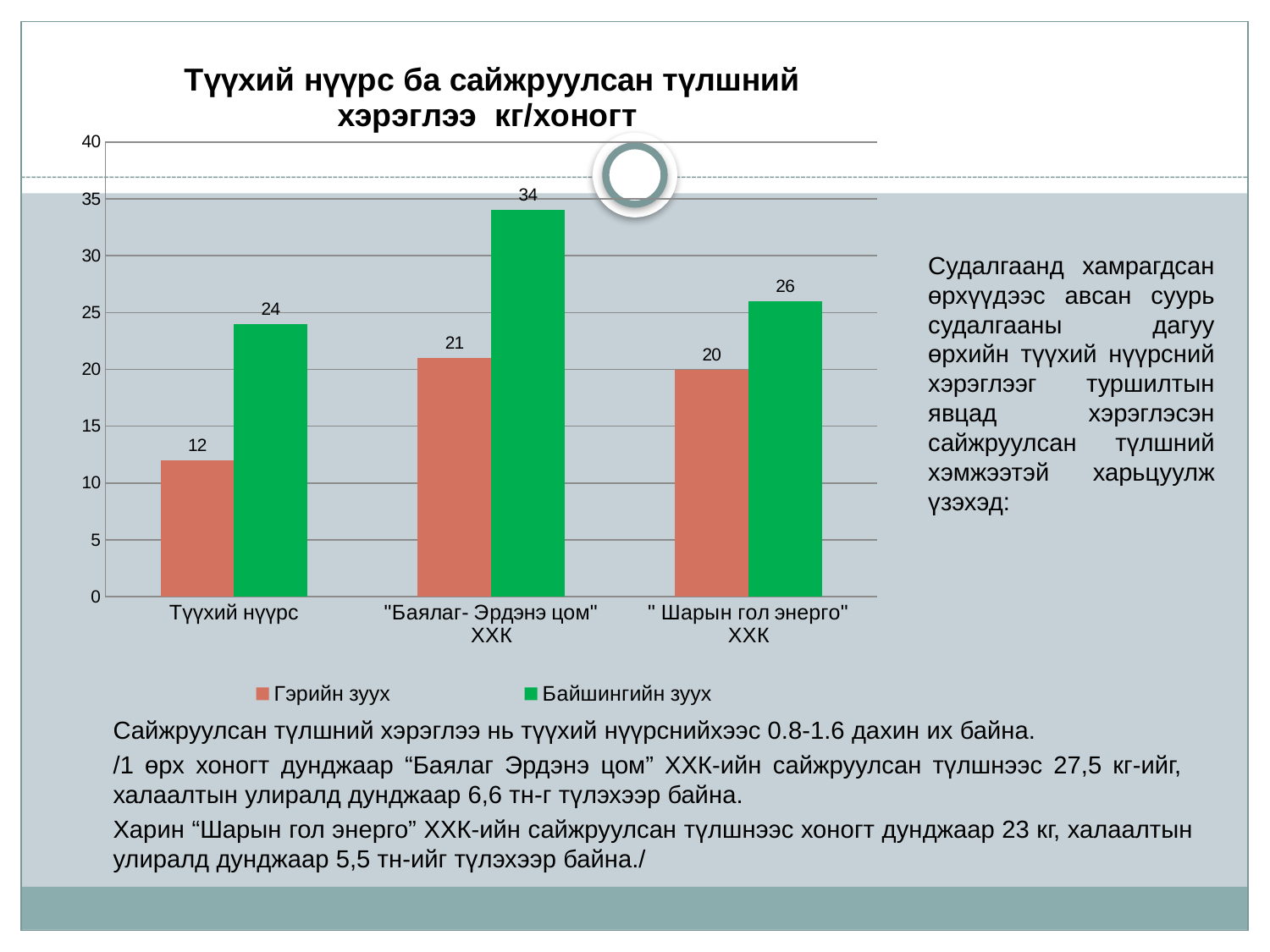
Which is larger: the Гэрийн зуух value for "Баялаг- Эрдэнэ цом" ХХК or for " Шарын гол энерго" ХХК? "Баялаг- Эрдэнэ цом" ХХК Which category has the lowest value for Гэрийн зуух? Түүхий нүүрс What is the value for Гэрийн зуух in the Түүхий нүүрс category? 12 What colour are the bars for the Байшингийн зуух series? green How many categories are shown on the x axis? 3 How many series does the legend list? 2 What is the value for Байшингийн зуух in the " Шарын гол энерго" ХХК category? 26 What type of chart is shown on the slide? bar chart What is the difference between the Байшингийн зуух and Гэрийн зуух values in the Түүхий нүүрс category? 12 What is the value for Байшингийн зуух in the "Баялаг- Эрдэнэ цом" ХХК category? 34 Which category has the highest value for Байшингийн зуух? "Баялаг- Эрдэнэ цом" ХХК What is the value for Гэрийн зуух in the " Шарын гол энерго" ХХК category? 20